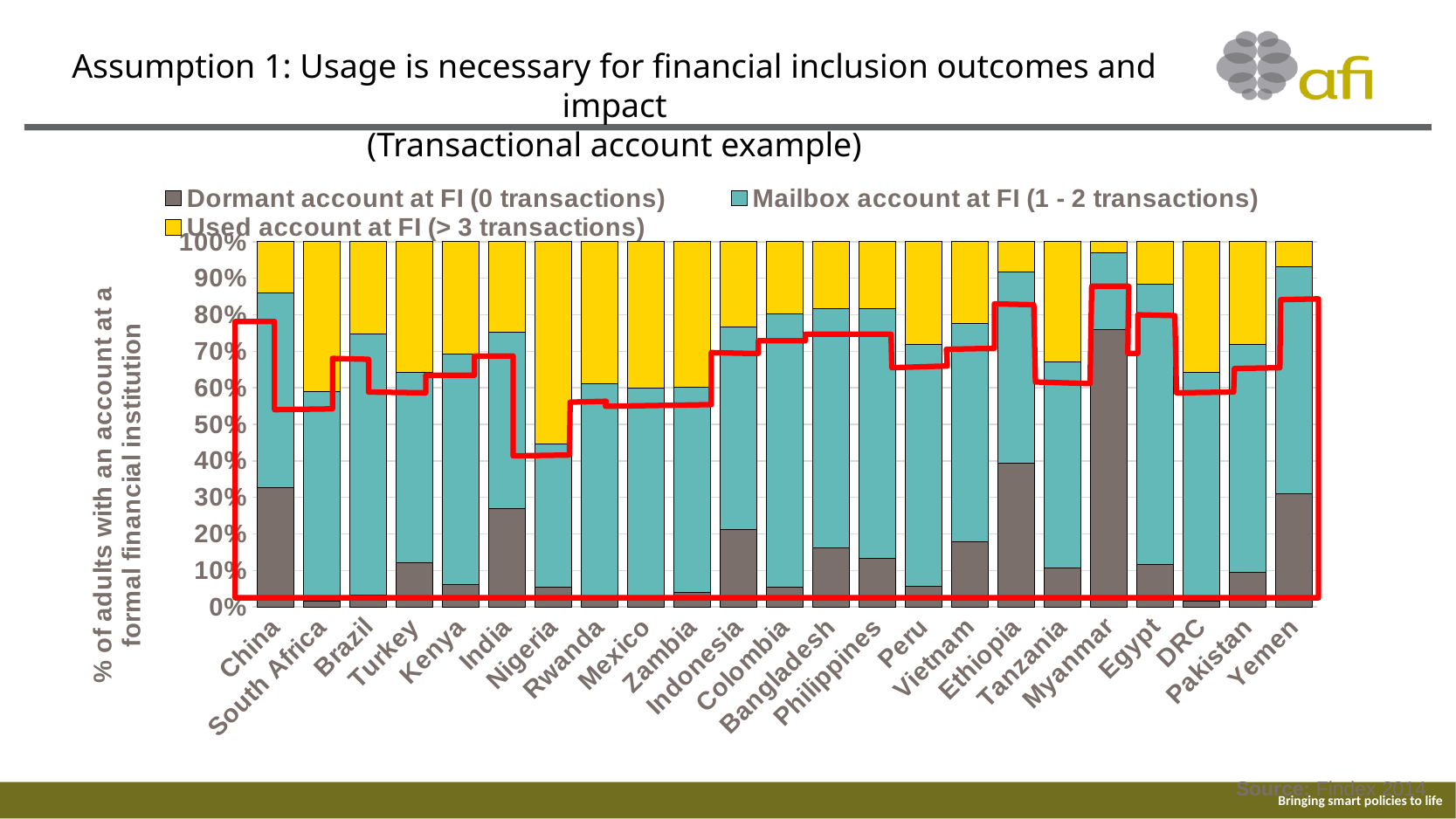
Is the dormant account share for Myanmar greater or less than 70%? greater Is the dormant account share for China greater or less than 20%? greater Which country has the highest share of dormant accounts at FI (0 transactions)? Myanmar How many series does the legend list? 3 What is the label of the y axis? % of adults with an account at a formal financial institution What is the total of the stacked bar for each country? 100% Is the combined dormant and mailbox account share for Nigeria greater or less than 50%? less What kind of chart is shown on the slide? stacked bar chart Which legend entry is shown in yellow? Used account at FI (> 3 transactions) Which has a larger dormant account share, China or South Africa? China How many countries are shown on the x axis? 23